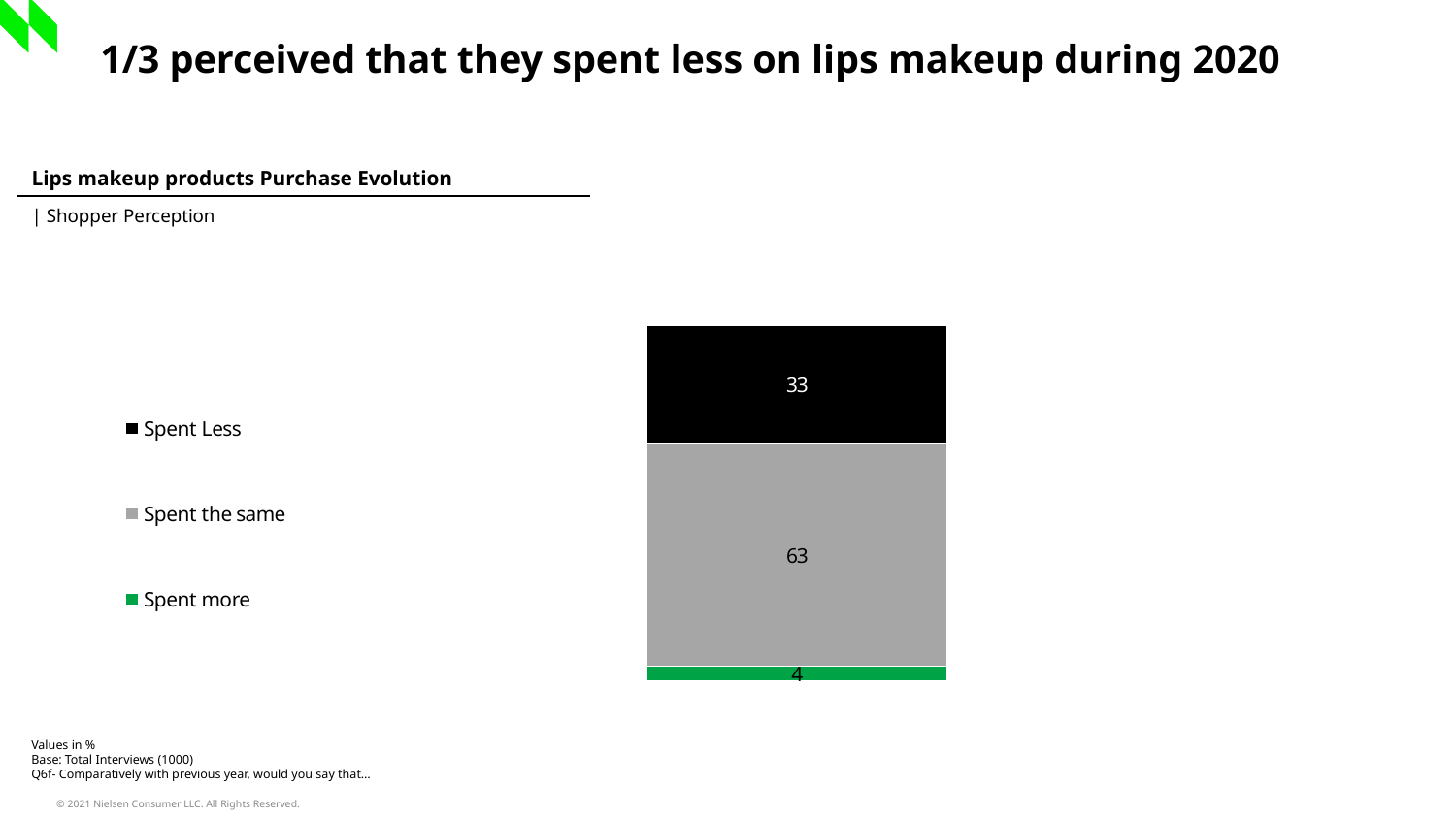
Which segment has the lowest value? Spent more What kind of chart is shown on the slide? Stacked bar chart What value is shown for the Spent the same segment? 63 What is the total of the stacked bar? 100 What is the difference between the Spent the same value and the Spent Less value? 30 Which segment has the highest value? Spent the same What value is shown for the Spent Less segment? 33 What is the difference between the Spent Less value and the Spent more value? 29 How many series does the legend list? 3 What colour is the Spent more segment in the legend? Green Which is larger, the value for Spent Less or the value for Spent more? Spent Less What value is shown for the Spent more segment? 4